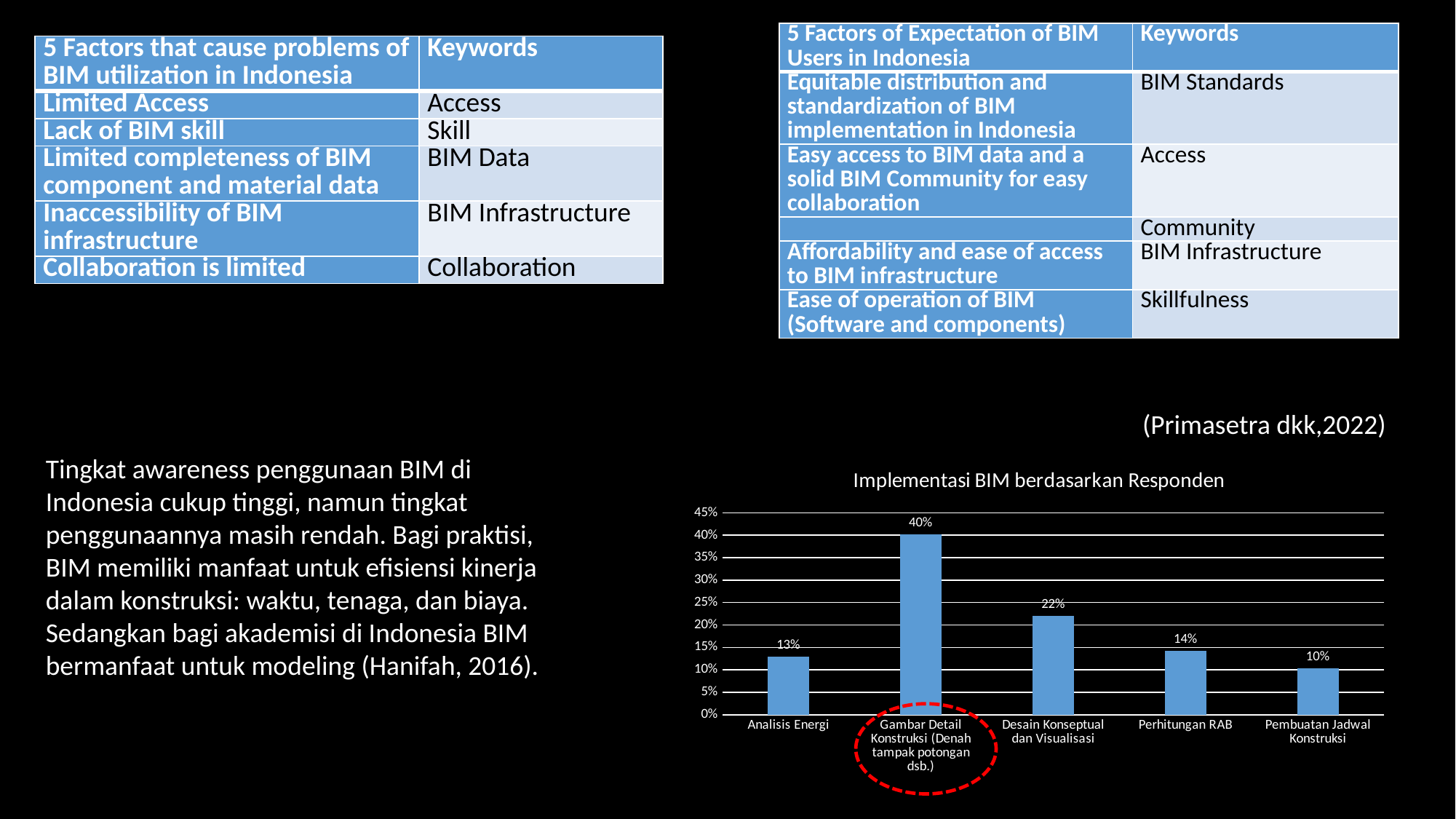
What is the value for Perhitungan RAB? 14% What kind of chart is shown on the slide? Bar chart How many categories are shown in the chart? 5 Which category has the highest value in the chart? Gambar Detail Konstruksi (Denah tampak potongan dsb.) What is the value for Analisis Energi in the chart 'Implementasi BIM berdasarkan Responden'? 13% Which category has the lowest value in the chart? Pembuatan Jadwal Konstruksi Which is larger, the value for Perhitungan RAB or the value for Analisis Energi? Perhitungan RAB What is the value for Desain Konseptual dan Visualisasi? 22% What is the title of the chart on the slide? Implementasi BIM berdasarkan Responden What is the value for Pembuatan Jadwal Konstruksi? 10% What is the value for Gambar Detail Konstruksi (Denah tampak potongan dsb.)? 40% What is the difference between the values for Gambar Detail Konstruksi and Desain Konseptual dan Visualisasi? 18%